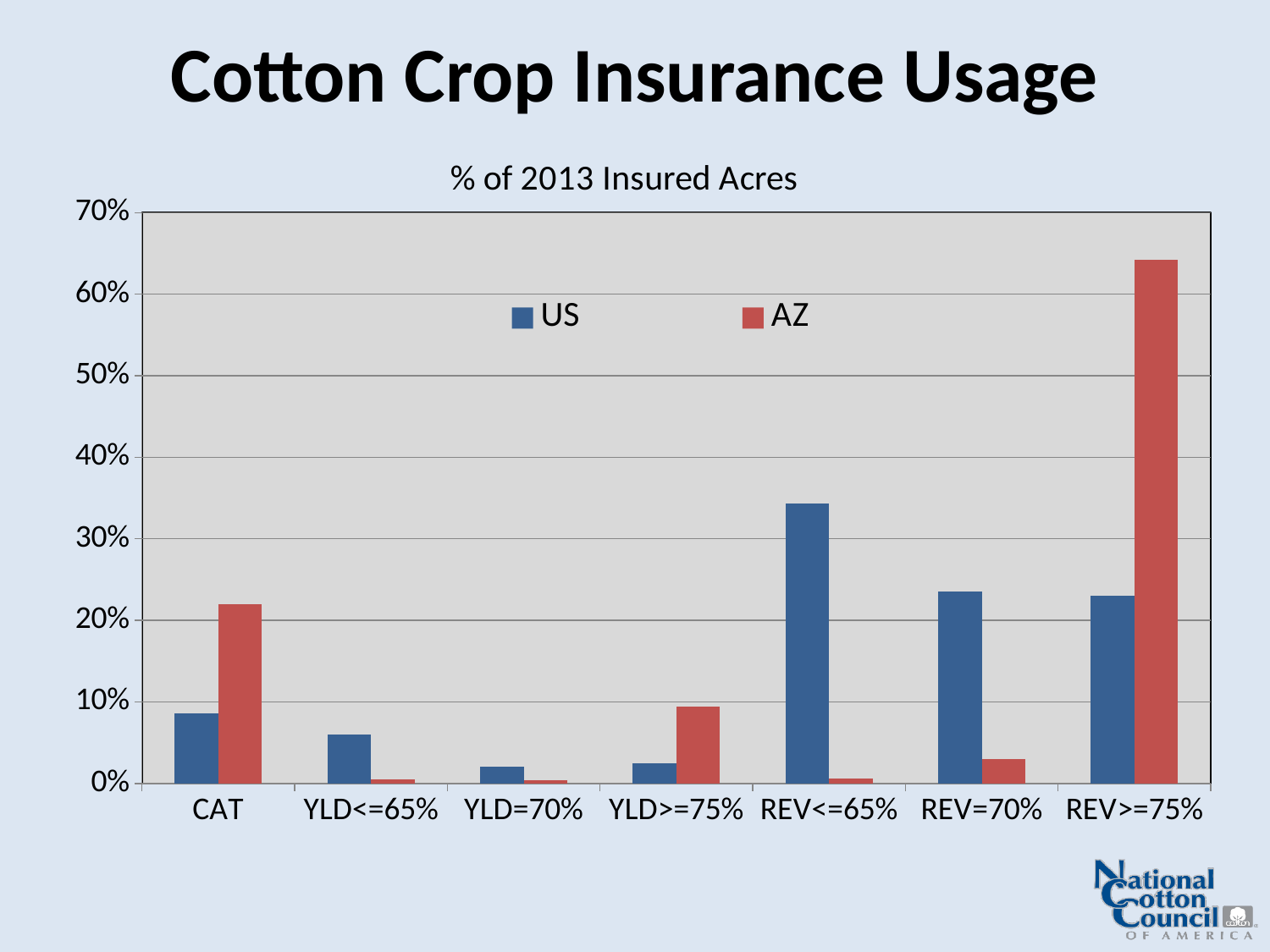
Is the US value for CAT greater or less than 10%? less Is the US value for REV<=65% greater or less than 30%? greater How many categories are shown on the x axis? 7 Is the AZ value for REV>=75% greater or less than 60%? greater For CAT, which is larger, the US value or the AZ value? AZ What is the subtitle shown above the chart? % of 2013 Insured Acres Which category has the highest AZ value? REV>=75% What kind of chart is shown on the slide? bar chart Which category has the lowest US value? YLD=70% How many series does the legend list? 2 For REV<=65%, which is larger, the US value or the AZ value? US Which category has the highest US value? REV<=65%